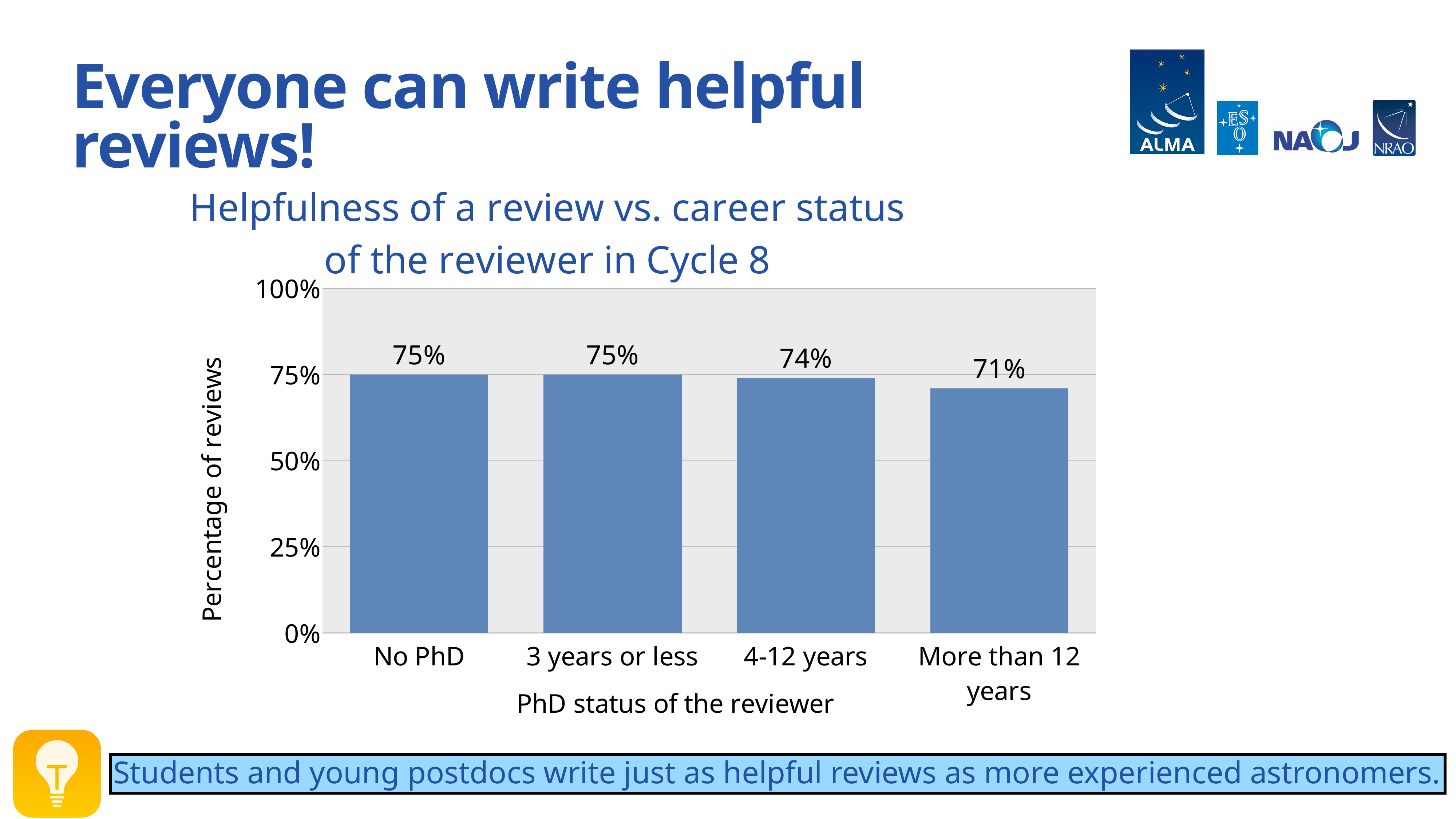
What percentage of reviews is shown for reviewers with a PhD of 4-12 years? 74% What percentage of reviews is shown for reviewers with No PhD? 75% What percentage of reviews is shown for reviewers with a PhD of 3 years or less? 75% What is the difference between the percentage for No PhD and the percentage for More than 12 years? 4% Which PhD status category has the lowest percentage of reviews? More than 12 years What is the difference between the percentage for 4-12 years and the percentage for More than 12 years? 3% Which is larger, the value for 4-12 years or the value for More than 12 years? 4-12 years What is the label of the y axis of the chart? Percentage of reviews How many PhD status categories are shown on the x axis? 4 What kind of chart is shown on the slide? Bar chart Is the value for More than 12 years greater or less than 50%? greater What percentage of reviews is shown for reviewers with a PhD of More than 12 years? 71%